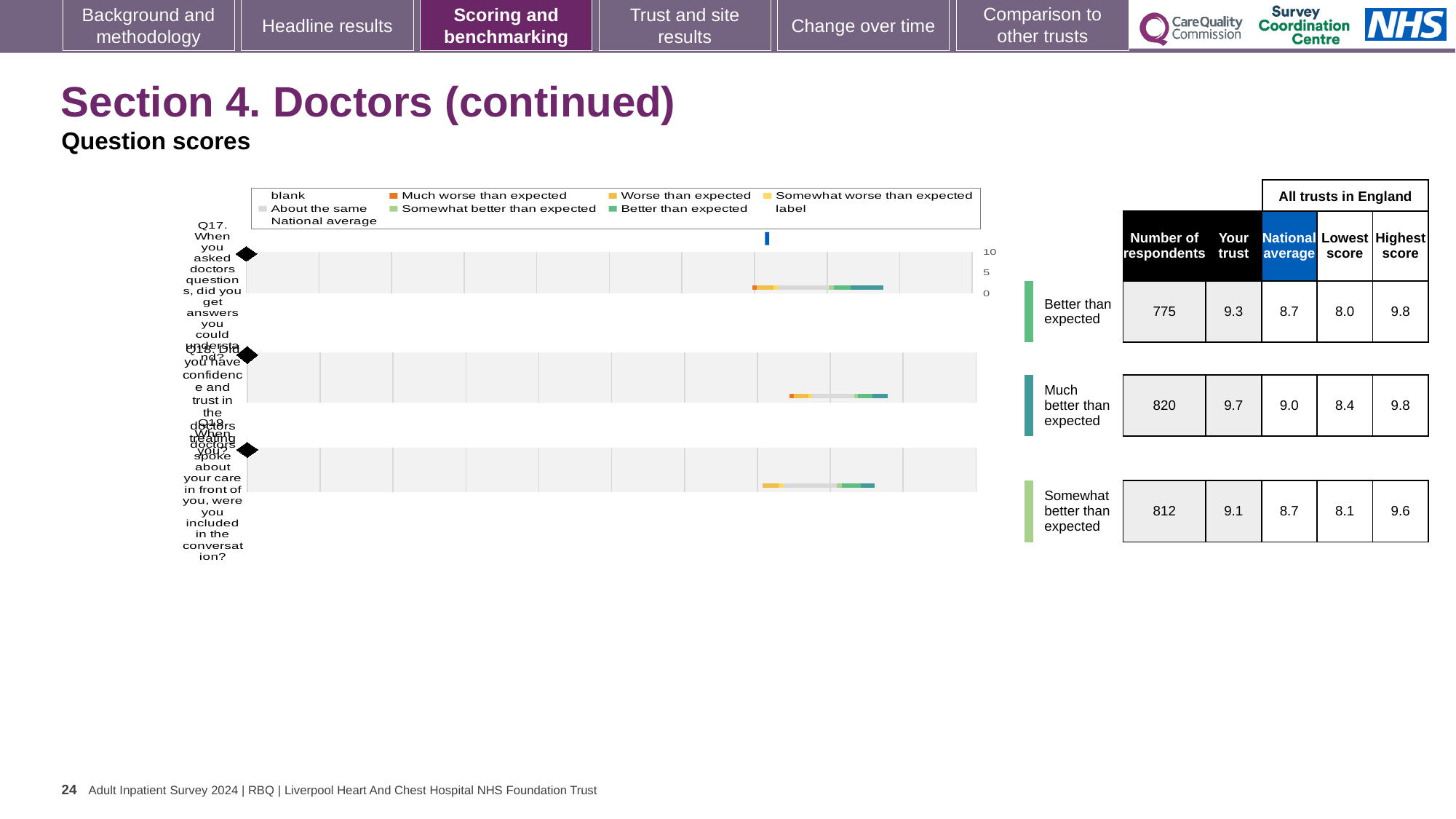
What is the number of respondents for Q17 (getting answers you could understand from doctors)? 775 What is the highest score in England for Q19? 9.6 How many entries does the chart legend list? 9 What benchmark category is Q18 placed in? Much better than expected Which question has the highest 'Your trust' score? Q18 What is the 'Your trust' score for Q18 (confidence and trust in the doctors treating you)? 9.7 How many questions (categories) are plotted in the chart? 3 What is the difference between the 'Your trust' score and the national average for Q18? 0.7 What is the national average score for Q19 (being included in the conversation when doctors spoke about your care)? 8.7 Is the 'Your trust' score for Q17 larger than the lowest score in England for Q17? Yes What kind of chart is used to show the question scores on this slide? bar chart Which question has the lowest 'Your trust' score? Q19